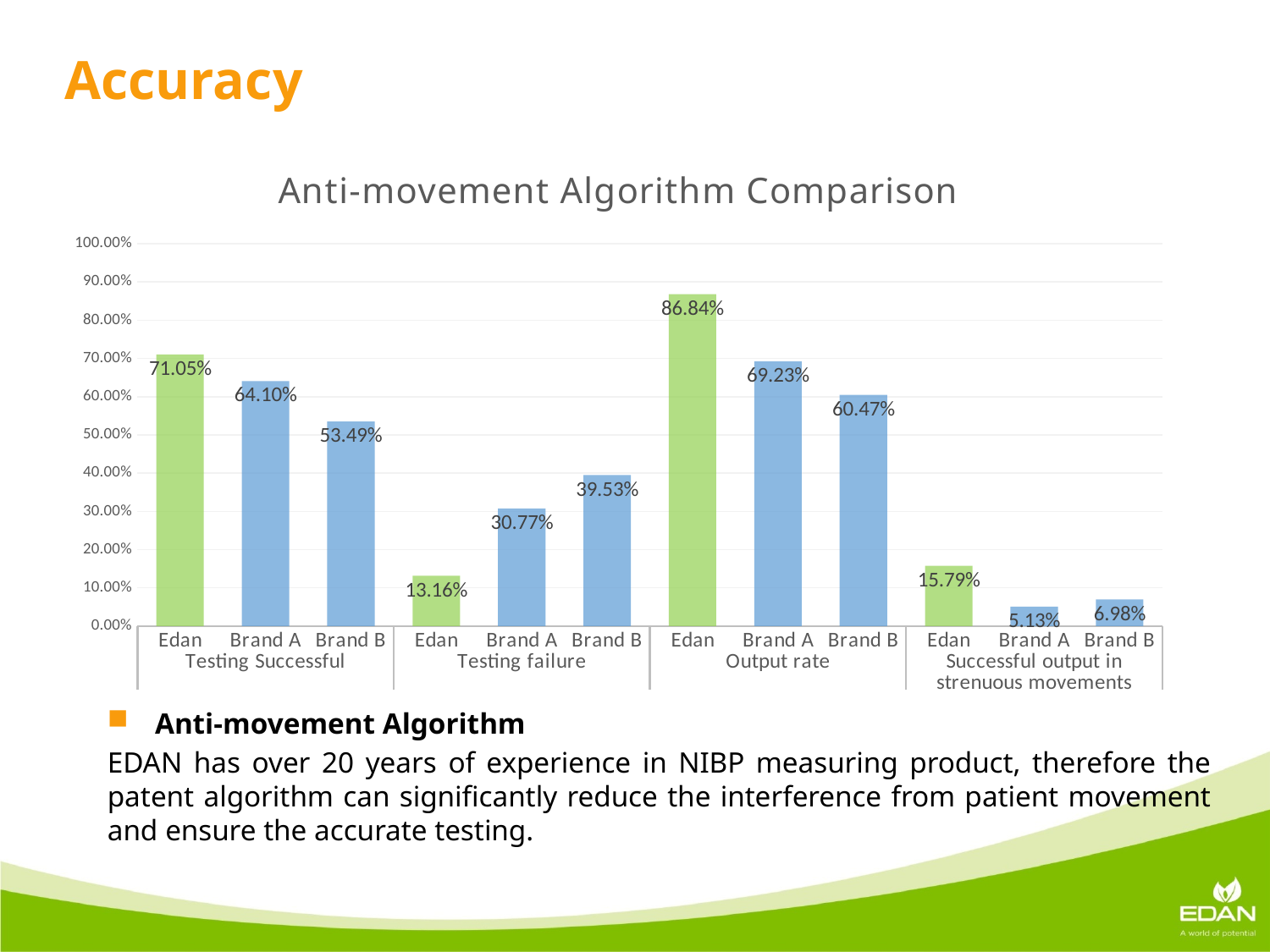
What is the value for Brand B in the Testing failure group? 39.53% Is the value for Brand B in the Output rate group greater or less than 50.00%? greater What is the title of the chart? Anti-movement Algorithm Comparison In the Testing failure group, which is larger, Edan or Brand A? Brand A How many category groups are shown along the x axis? 4 Which bar has the lowest value on the chart? Brand A, Successful output in strenuous movements (5.13%) What kind of chart is shown on the slide? Bar chart What is the value for Brand A in the Successful output in strenuous movements group? 5.13% What is the difference between Edan and Brand B in the Testing Successful group? 17.56% What is the value for Edan in the Testing Successful group? 71.05% Which bar has the highest value on the chart? Edan, Output rate (86.84%) What is the value for Brand A in the Output rate group? 69.23%